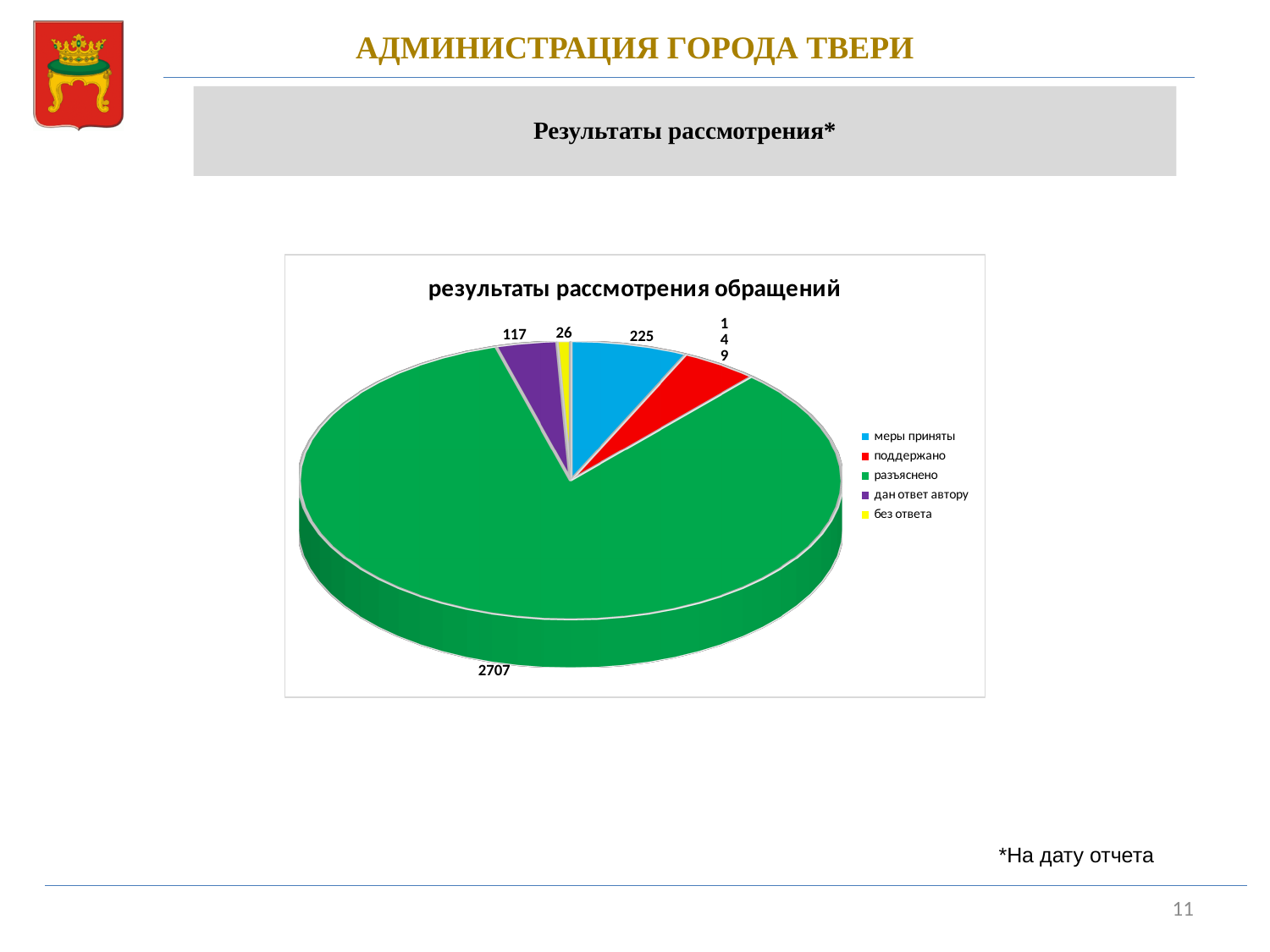
What is the value for "меры приняты"? 225 What is the difference between the values for "меры приняты" and "поддержано"? 76 How many slices does the pie chart have? 5 What is the value for "разъяснено"? 2707 How many entries does the legend list? 5 Which category has the smallest slice? без ответа What is the title of the chart? результаты рассмотрения обращений What is the value for "дан ответ автору"? 117 What type of chart is shown on the slide? pie chart What is the value for "без ответа"? 26 Which category has the largest slice? разъяснено Which is larger, the value for "дан ответ автору" or the value for "без ответа"? дан ответ автору